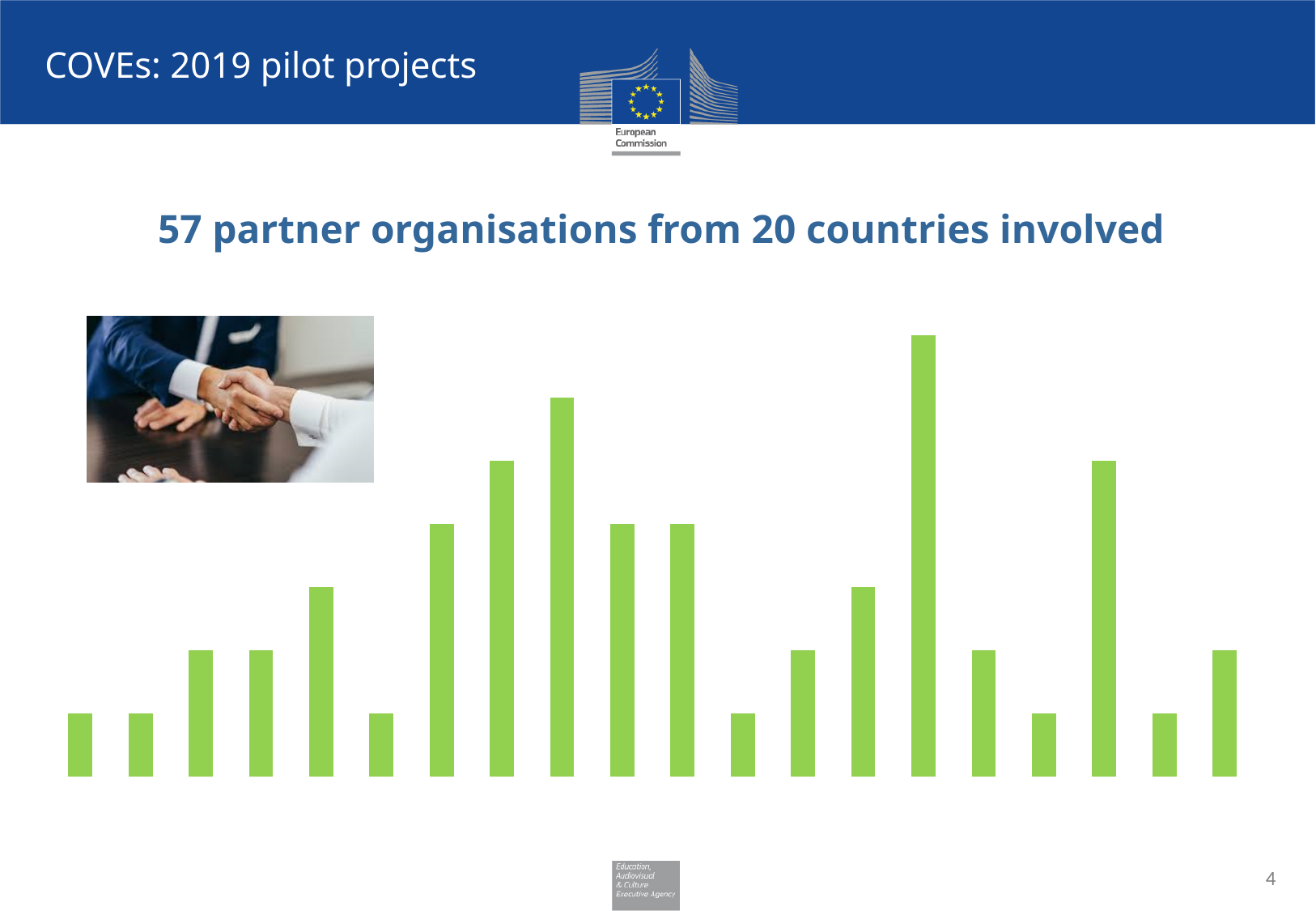
What is the heading text shown above the chart? 57 partner organisations from 20 countries involved What colour are the bars in the chart? green How many bars does the chart on the slide contain? 20 Which is taller: the 3rd bar from the left or the 5th bar from the left? the 5th bar Counting from the left, which bar in the chart is the tallest? the 15th bar What kind of chart is shown on the slide? bar chart Is the 9th bar from the left taller or shorter than the 15th bar from the left? shorter